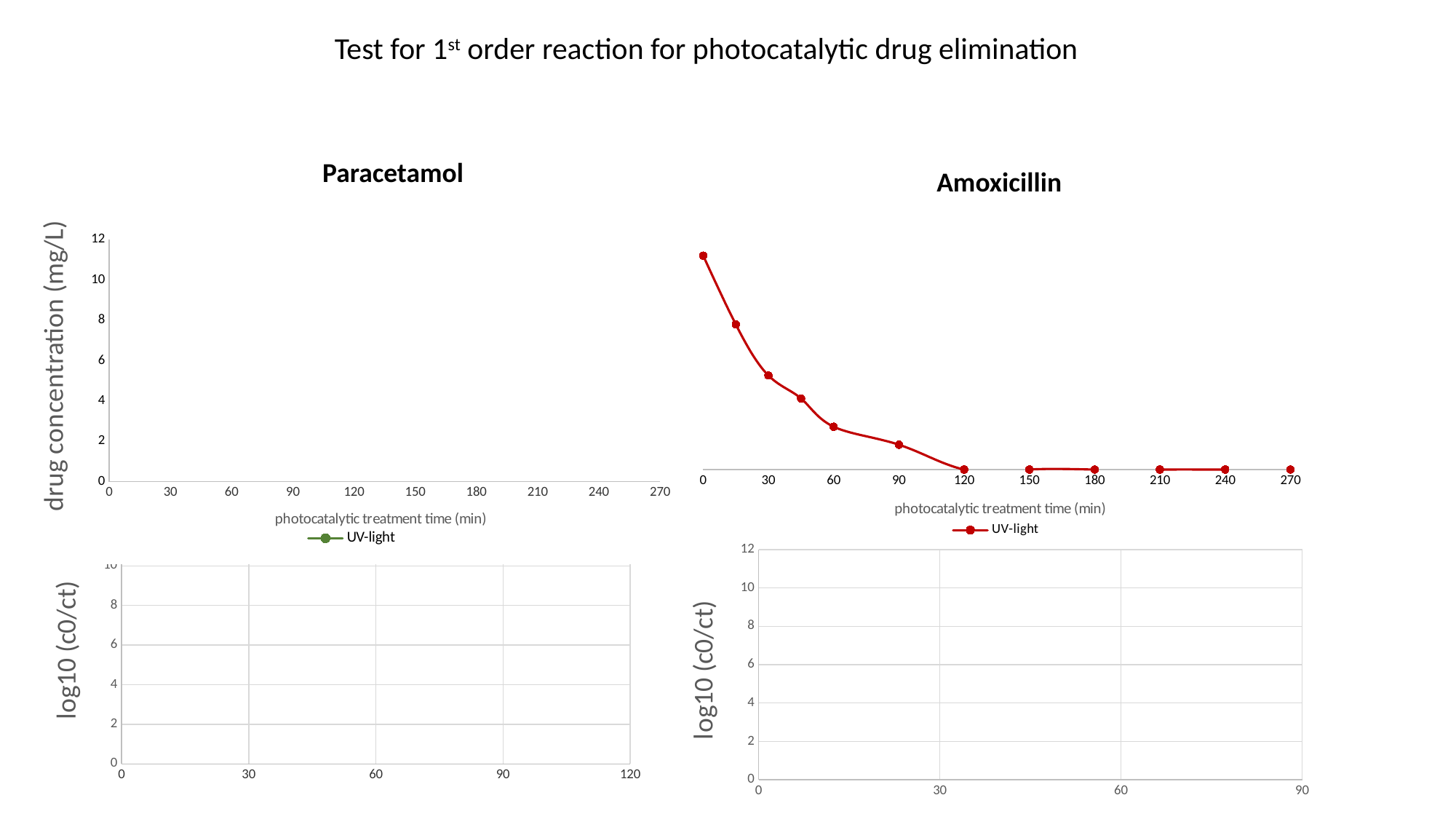
In the Amoxicillin chart, which is larger: the value at 30 min or the value at 90 min? 30 min In the Amoxicillin chart, do the values rise or fall as photocatalytic treatment time increases? fall How many series does the legend of the Amoxicillin chart list? 1 What kind of chart is the Amoxicillin chart at the top right of the slide? line chart What is the x-axis title of the Amoxicillin chart? photocatalytic treatment time (min) In the Amoxicillin chart, which is larger: the value at 120 min or the value at 45 min? 45 min How many data points are plotted in the Amoxicillin chart? 12 What is the name of the series shown in the legend of the Amoxicillin chart? UV-light In the Amoxicillin chart, at which treatment time is the drug concentration highest? 0 min In the Amoxicillin chart, which is larger: the value at 60 min or the value at 0 min? 0 min